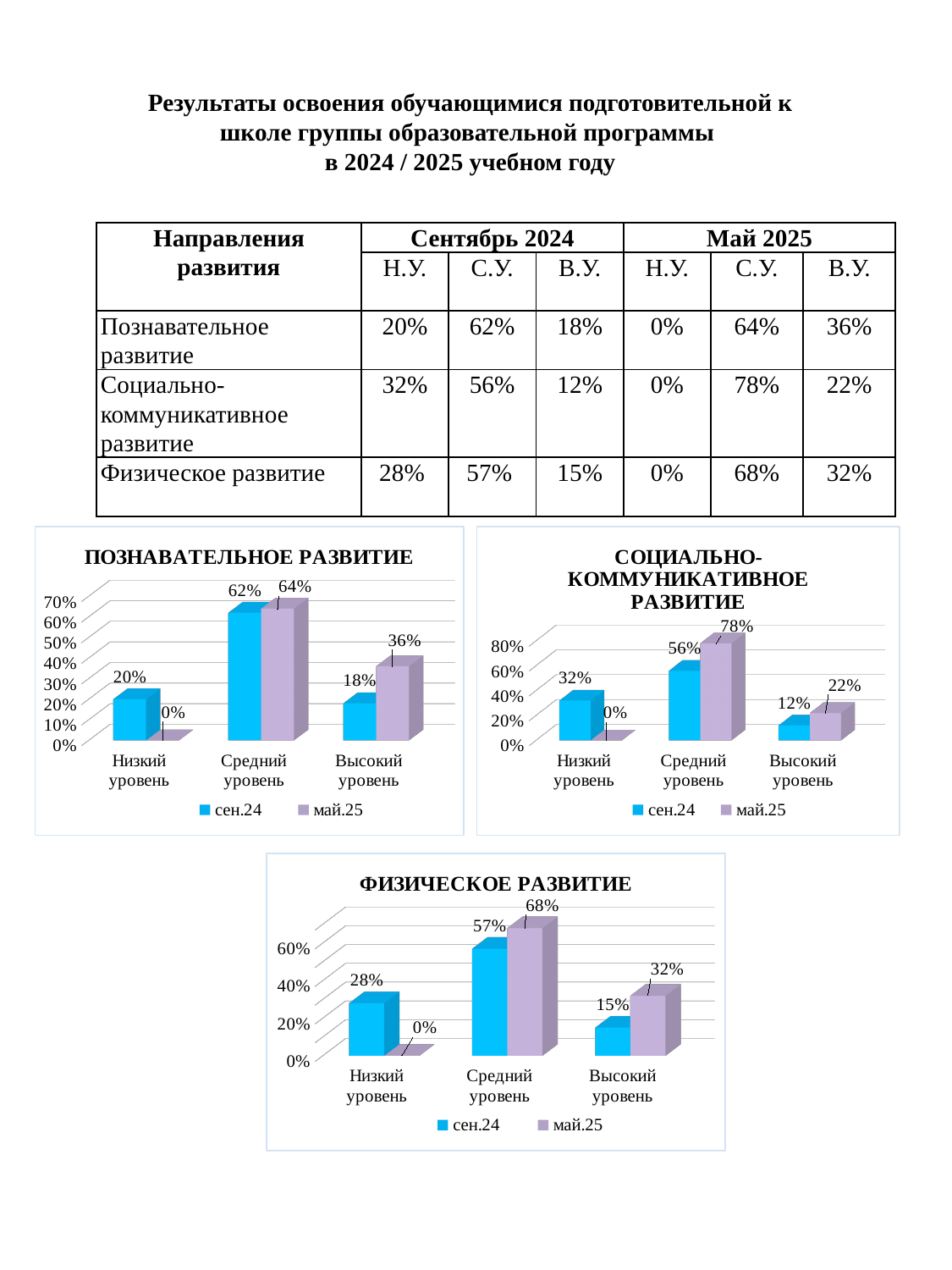
In the chart titled "СОЦИАЛЬНО-КОММУНИКАТИВНОЕ РАЗВИТИЕ", which category has the highest value in the "сен.24" series? Средний уровень In the chart titled "ПОЗНАВАТЕЛЬНОЕ РАЗВИТИЕ", what is the value for "Средний уровень" in the "май.25" series? 64% In the chart titled "СОЦИАЛЬНО-КОММУНИКАТИВНОЕ РАЗВИТИЕ", what is the value for "Средний уровень" in the "май.25" series? 78% In the chart titled "ПОЗНАВАТЕЛЬНОЕ РАЗВИТИЕ", what is the difference between the "май.25" and "сен.24" values for "Высокий уровень"? 18% In the chart titled "ФИЗИЧЕСКОЕ РАЗВИТИЕ", which category has the lowest value in the "май.25" series? Низкий уровень In the chart titled "ФИЗИЧЕСКОЕ РАЗВИТИЕ", what is the value for "Высокий уровень" in the "сен.24" series? 15% How many series does the legend list in the chart titled "ФИЗИЧЕСКОЕ РАЗВИТИЕ"? 2 In the chart titled "ПОЗНАВАТЕЛЬНОЕ РАЗВИТИЕ", what is the value for "Низкий уровень" in the "сен.24" series? 20% In the chart titled "СОЦИАЛЬНО-КОММУНИКАТИВНОЕ РАЗВИТИЕ", which is larger for "Высокий уровень": the "сен.24" value or the "май.25" value? май.25 What kind of chart is the chart titled "СОЦИАЛЬНО-КОММУНИКАТИВНОЕ РАЗВИТИЕ"? Bar chart How many categories are shown on the x axis of the chart titled "ПОЗНАВАТЕЛЬНОЕ РАЗВИТИЕ"? 3 In the chart titled "ФИЗИЧЕСКОЕ РАЗВИТИЕ", what is the difference between the "май.25" and "сен.24" values for "Средний уровень"? 11%